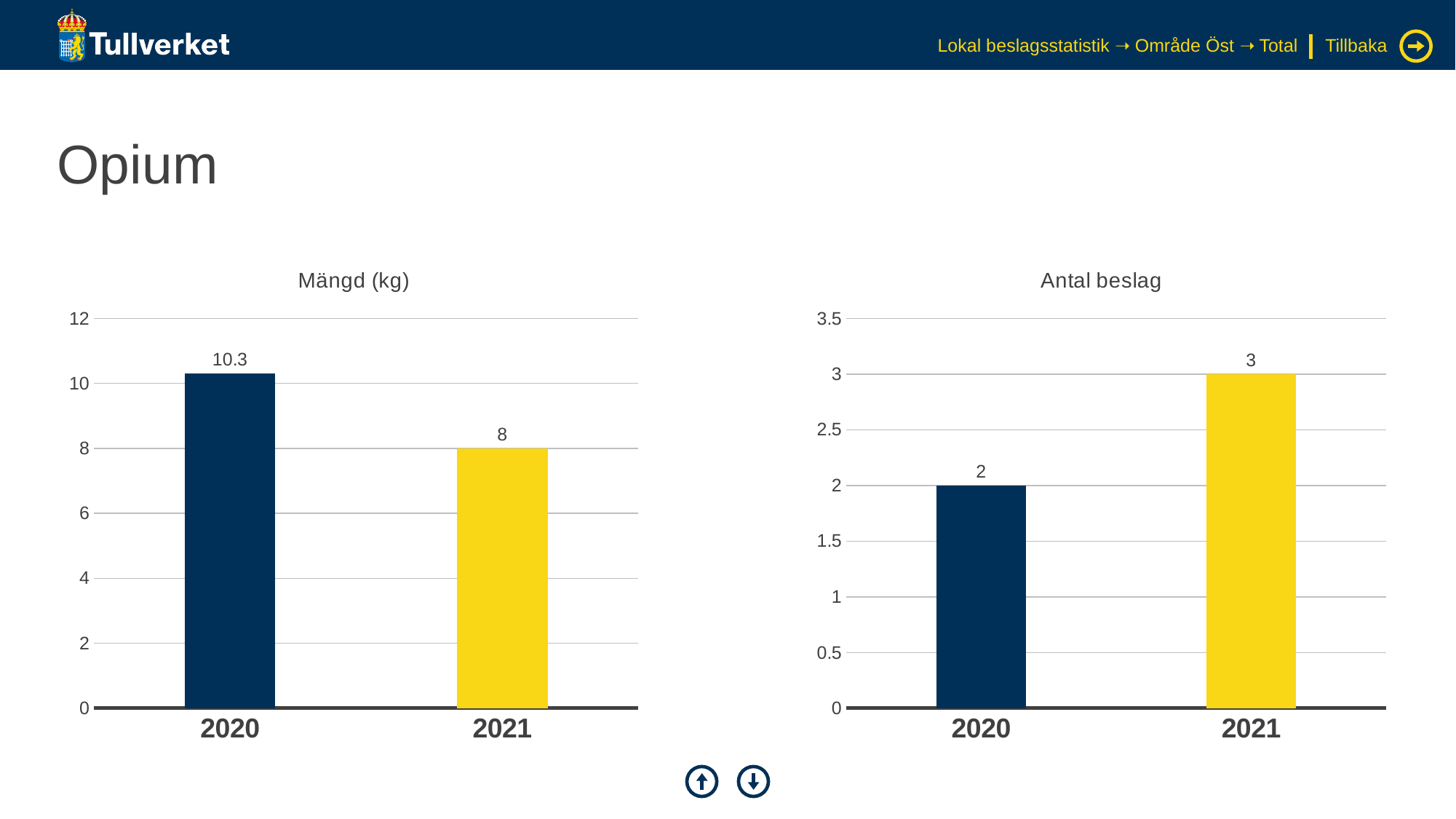
In the 'Antal beslag' chart, what is the value for 2021? 3 In the 'Antal beslag' chart, which year has the lowest value? 2020 In the 'Mängd (kg)' chart, what is the value for 2020? 10.3 In the 'Mängd (kg)' chart, what is the value for 2021? 8 In the 'Mängd (kg)' chart, which year has the highest value? 2020 In the 'Antal beslag' chart, what is the difference between the values for 2021 and 2020? 1 In the 'Antal beslag' chart, which year has the larger value, 2020 or 2021? 2021 In the 'Antal beslag' chart, what is the value for 2020? 2 In the 'Mängd (kg)' chart, do the values rise or fall from 2020 to 2021? fall What kind of chart is the 'Mängd (kg)' chart? bar chart How many categories are shown on the x axis of the 'Antal beslag' chart? 2 In the 'Mängd (kg)' chart, what is the difference between the values for 2020 and 2021? 2.3